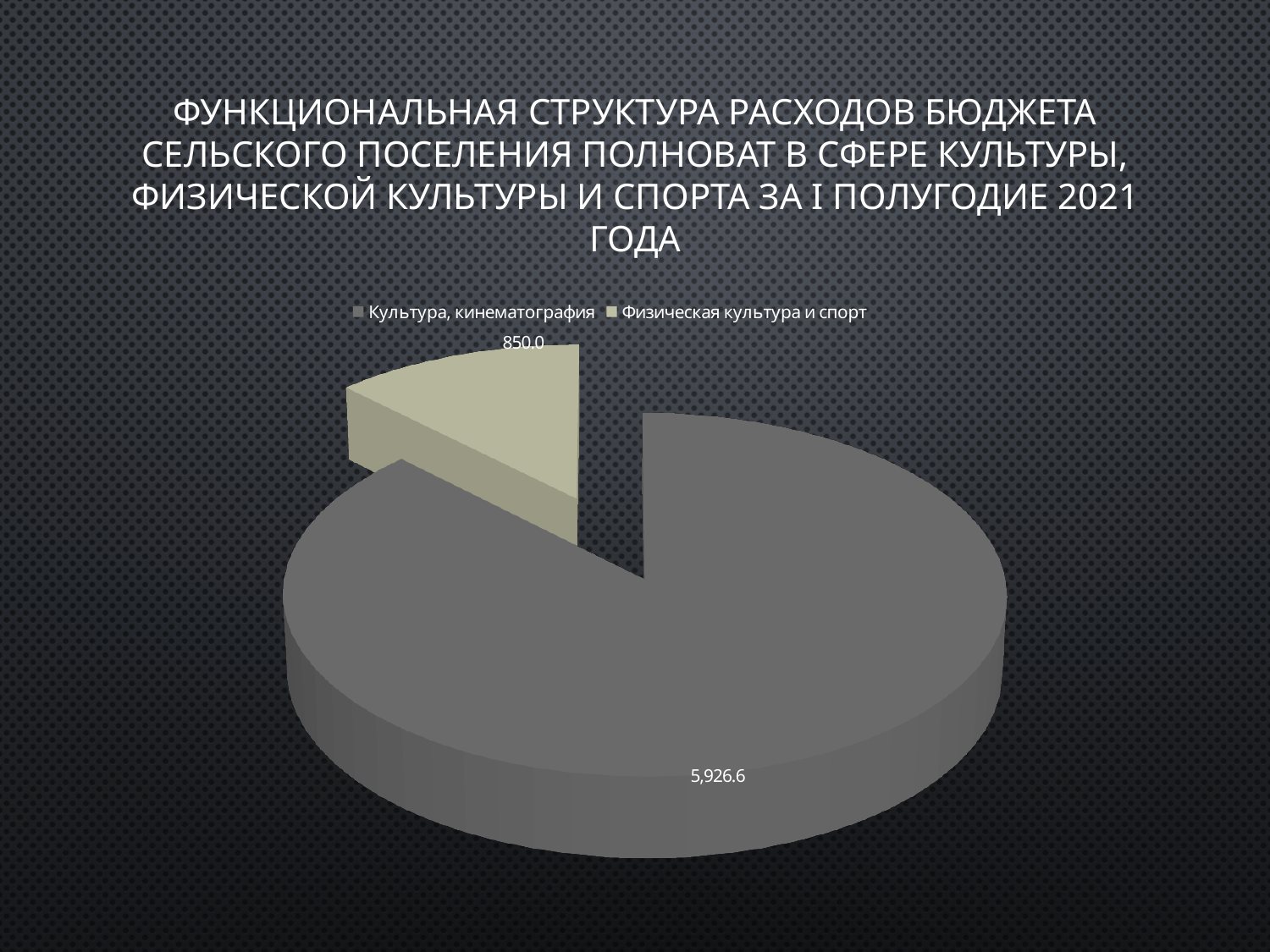
How many slices does the pie chart have? 2 What is the total of the two values shown in the pie chart? 6,776.6 Which category has the smallest slice of the pie? Физическая культура и спорт What is the difference between the values for Культура, кинематография and Физическая культура и спорт? 5,076.6 What is the value for Культура, кинематография? 5,926.6 Which category has the largest slice of the pie? Культура, кинематография Which legend entry is shown in the lighter (beige) colour? Физическая культура и спорт Which is larger: the value for Культура, кинематография or the value for Физическая культура и спорт? Культура, кинематография What type of chart is shown on the slide? Pie chart How many entries does the legend list? 2 What share of the pie does Физическая культура и спорт represent, to the nearest whole percent? 13% What is the value for Физическая культура и спорт? 850.0